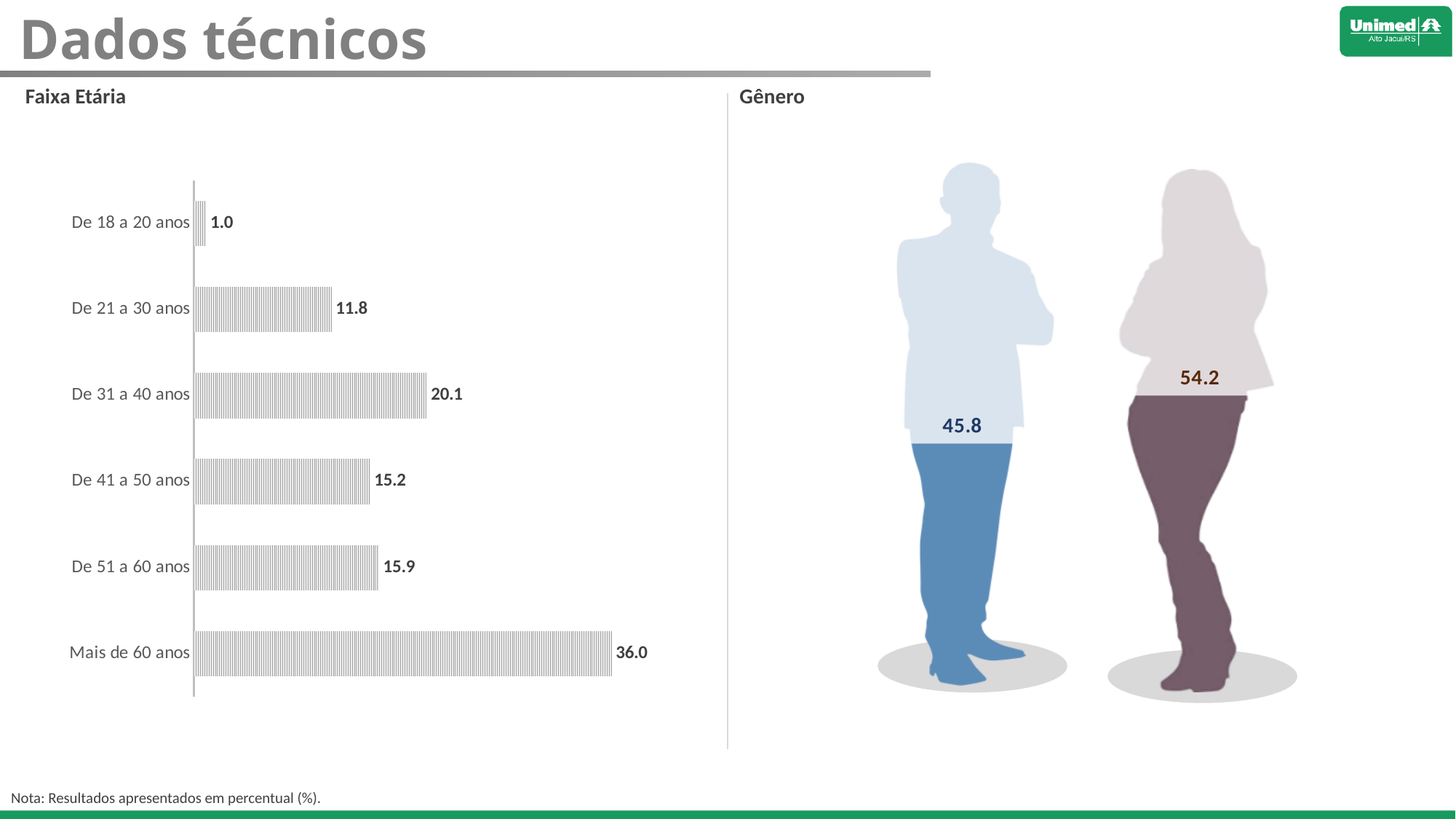
In the Faixa Etária chart, which age group has the lowest value? De 18 a 20 anos In the Faixa Etária chart, which is larger: the value for De 21 a 30 anos or De 41 a 50 anos? De 41 a 50 anos What kind of chart is the Faixa Etária chart? Bar chart How many age groups are shown in the Faixa Etária chart? 6 In the Faixa Etária chart, what is the value for De 21 a 30 anos? 11.8 In the Faixa Etária chart, which age group has the highest value? Mais de 60 anos In the Gênero graphic, what is the value shown for the female figure? 54.2 In the Faixa Etária chart, what is the value for De 31 a 40 anos? 20.1 In the Gênero graphic, what is the value shown for the male figure? 45.8 In the Faixa Etária chart, what is the difference between the values for Mais de 60 anos and De 31 a 40 anos? 15.9 In the Faixa Etária chart, what is the difference between the values for De 51 a 60 anos and De 41 a 50 anos? 0.7 In the Faixa Etária chart, what is the value for De 51 a 60 anos? 15.9